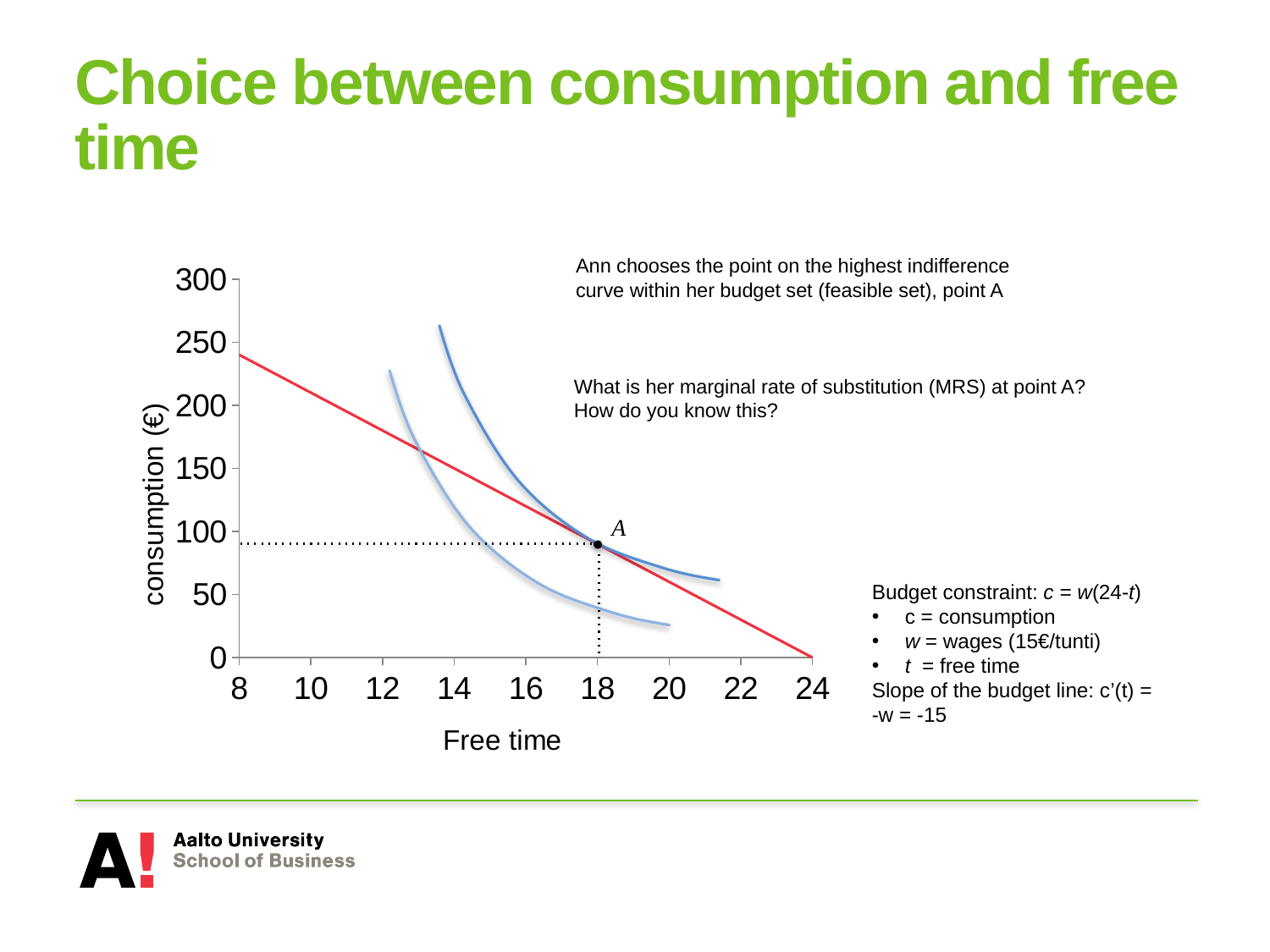
What is the label of the x axis? Free time Does consumption along the red budget line rise or fall as free time increases? fall Is the consumption value at point A greater or less than 50? greater At what value of free time does the red budget line reach a consumption of 0? 24 What is the highest value shown on the y axis? 300 Is the consumption value on the red budget line at free time 14 greater or less than 100? greater How many blue indifference curves are drawn on the chart? 2 What type of chart is shown on the slide? line chart What is the label of the y axis? consumption (€) At what value of free time is point A located? 18 Is the consumption value at point A greater or less than 100? less